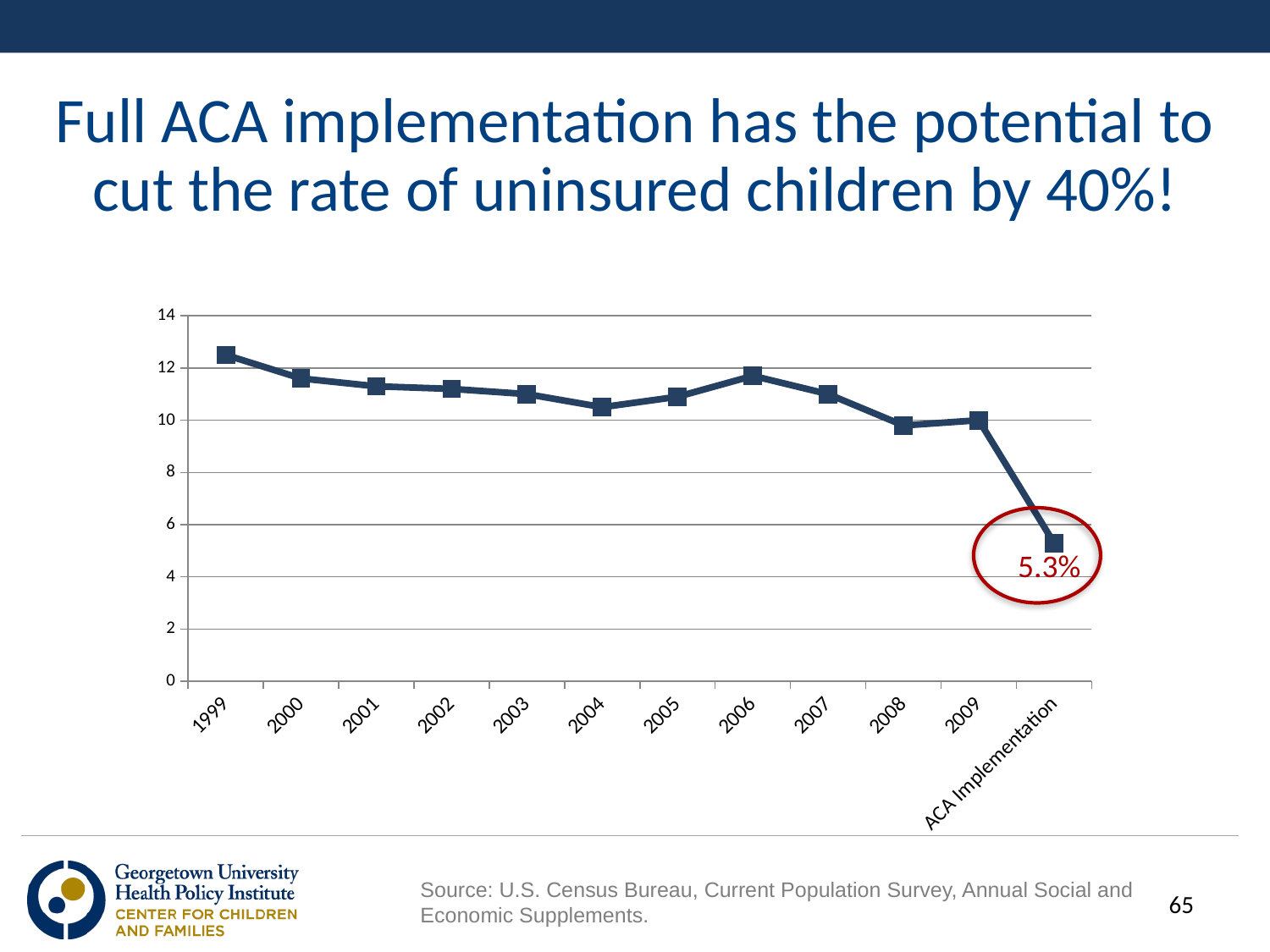
Which is larger, the value for 1999 or the value for 2006? 1999 Is the value for 1999 greater or less than 12? greater What is the title of the slide containing the chart? Full ACA implementation has the potential to cut the rate of uninsured children by 40%! Do the values generally rise or fall from 1999 to ACA Implementation? Fall How many data points are plotted on the line? 12 Which point on the x axis has the lowest value? ACA Implementation Which point on the x axis has the highest value? 1999 What kind of chart is shown on the slide? Line chart Is the value for ACA Implementation greater or less than 6? less Is the value for 2006 greater or less than 12? less What value is labelled for the ACA Implementation point? 5.3%